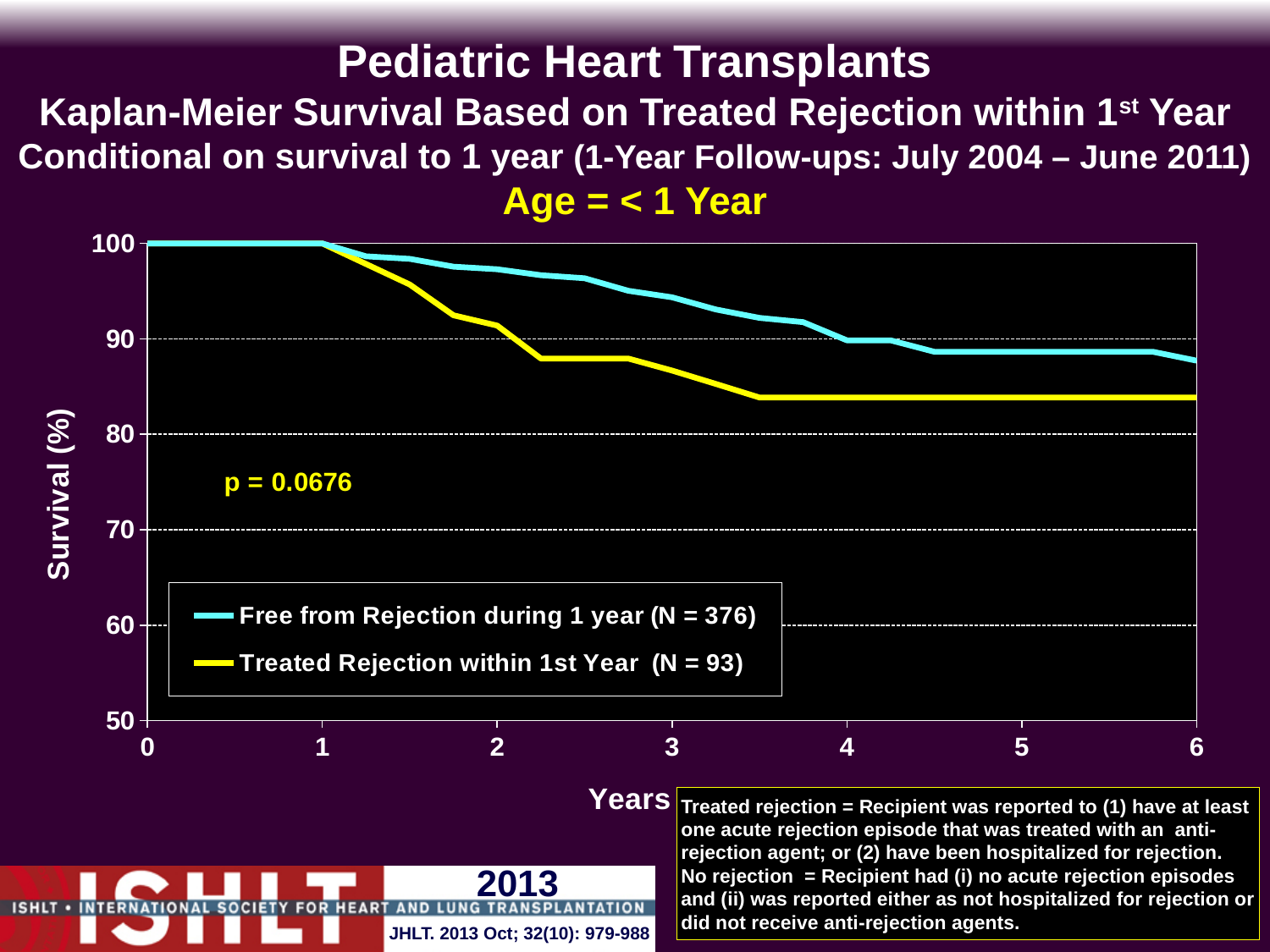
What is the N for the 'Free from Rejection during 1 year' group shown in the legend? 376 Is the survival value for the 'Treated Rejection within 1st Year' group at 4 years greater or less than 90? less Is the survival value for the 'Free from Rejection during 1 year' group at 6 years greater or less than 90? less Which group has the lower survival at 3 years? Treated Rejection within 1st Year Do the survival curves rise or fall as years increase? Fall At 5 years, which group has the higher survival: 'Free from Rejection during 1 year' or 'Treated Rejection within 1st Year'? Free from Rejection during 1 year Is the survival value for the 'Treated Rejection within 1st Year' group at 6 years greater or less than 90? less What kind of chart is shown on the slide? Line chart What is the N for the 'Treated Rejection within 1st Year' group shown in the legend? 93 How many series does the legend list? 2